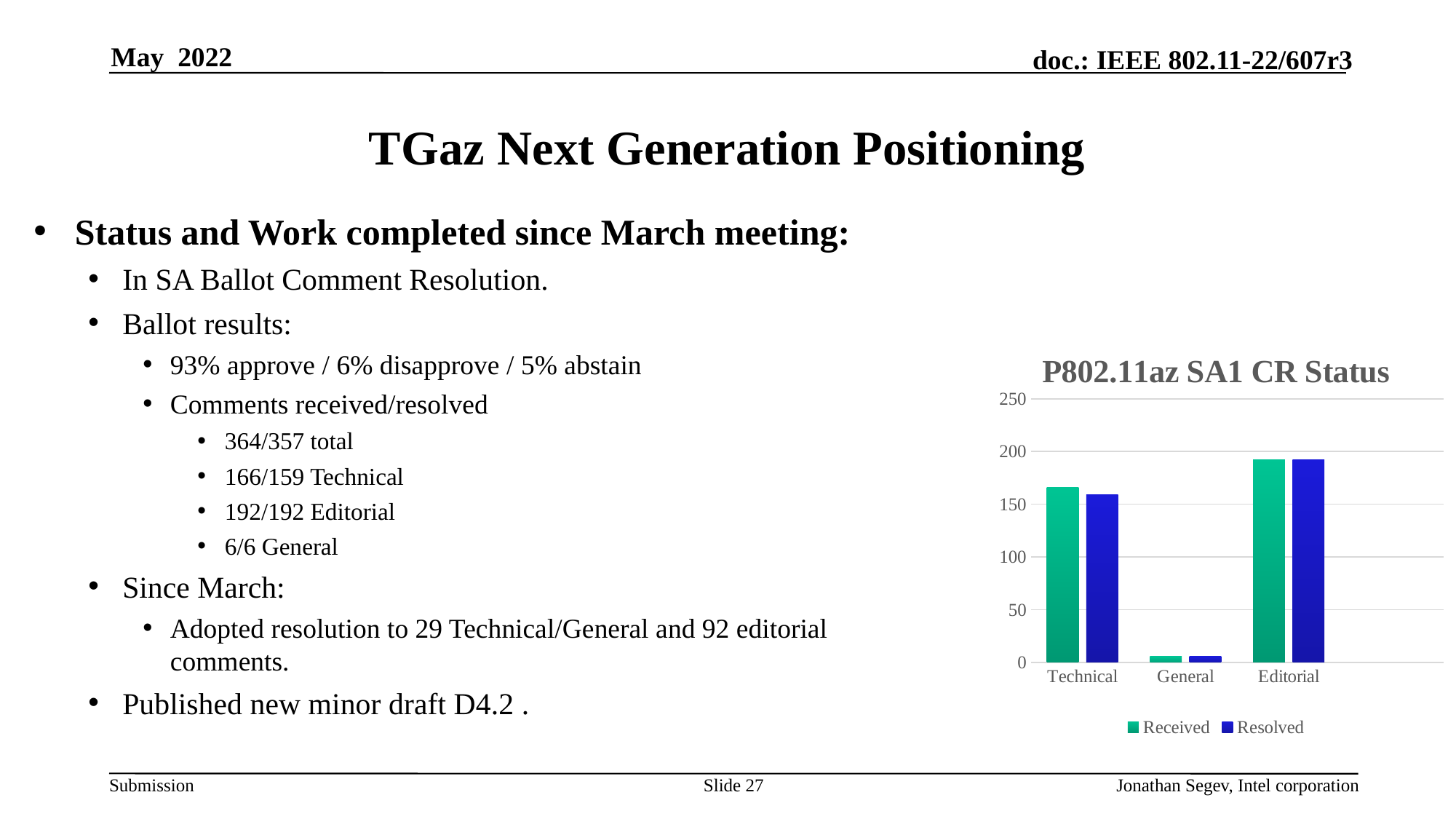
Is the Resolved value for Editorial greater or less than 150? greater Is the Received value for Editorial greater or less than 200? less How many series does the chart legend list? 2 What is the title of the chart? P802.11az SA1 CR Status Which series is shown in blue in the chart? Resolved How many categories are shown on the x axis of the chart? 3 Which category has the highest Received value in the chart? Editorial Is the Received value for Technical greater or less than 150? greater What kind of chart is shown on the slide? bar chart Which category has the lowest Resolved value in the chart? General For Technical, which is larger: Received or Resolved? Received